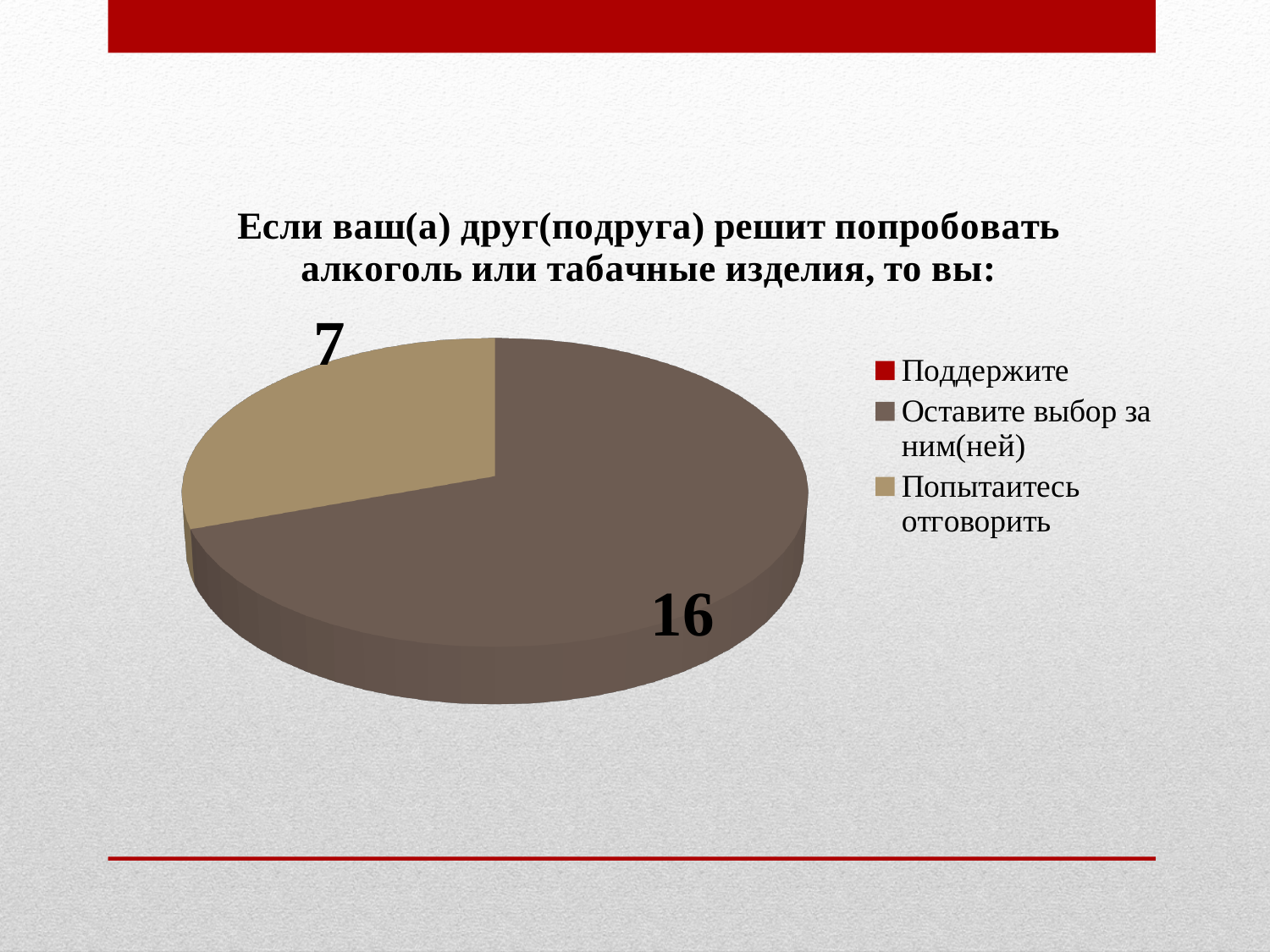
Which category has the largest slice of the pie? Оставите выбор за ним(ней) What is the difference between the values for "Оставите выбор за ним(ней)" and "Попытаитесь отговорить"? 9 What is the title of the chart? Если ваш(а) друг(подруга) решит попробовать алкоголь или табачные изделия, то вы: What value is shown for the slice "Попытаитесь отговорить"? 7 How many entries does the legend list? 3 Which legend entry is shown in red? Поддержите How many categories are listed in the legend of the chart? 3 Which is larger: the value for "Оставите выбор за ним(ней)" or the value for "Попытаитесь отговорить"? Оставите выбор за ним(ней) What kind of chart is shown on the slide? Pie chart What value is shown for the slice "Оставите выбор за ним(ней)"? 16